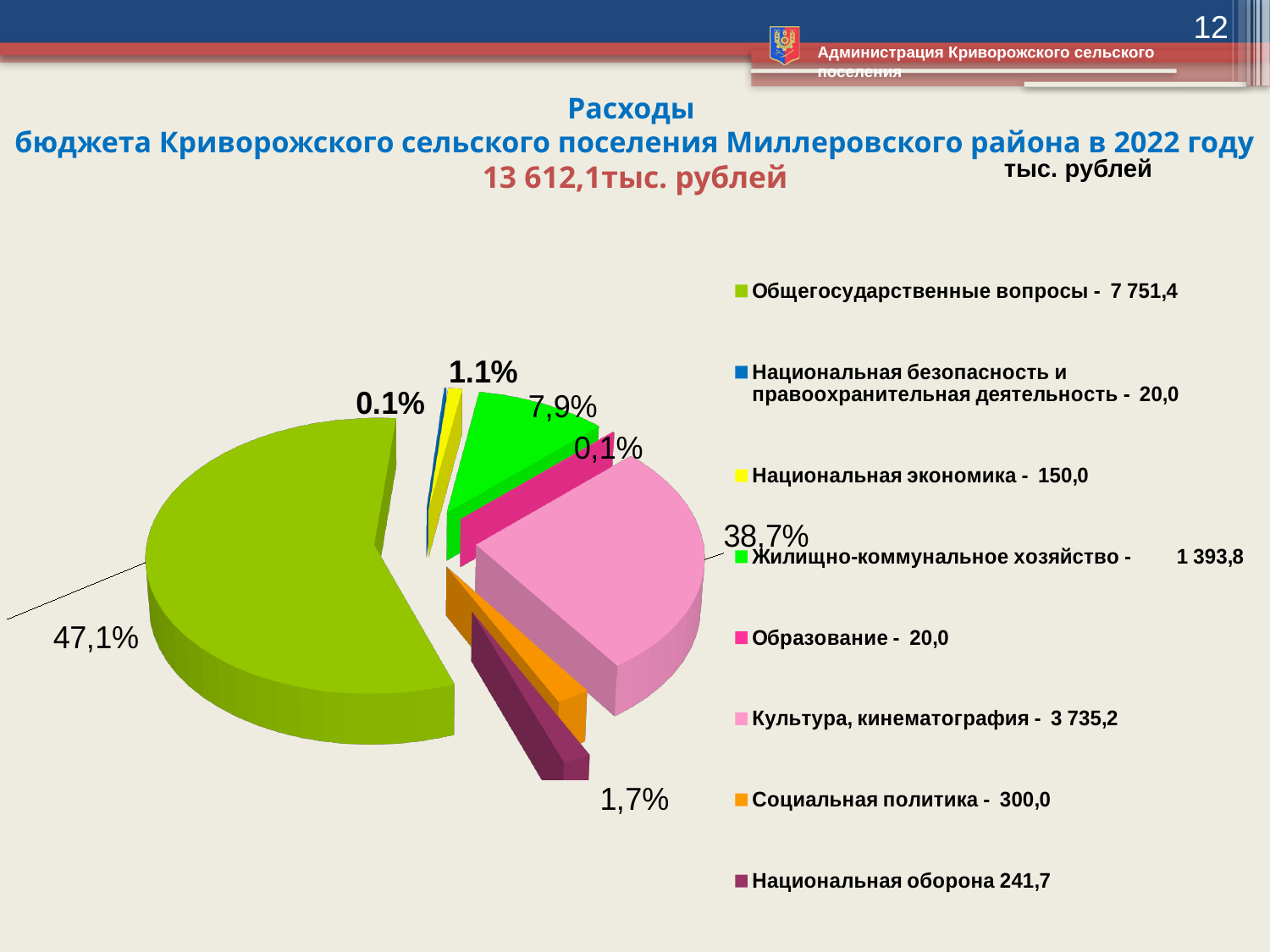
What total expenditure amount is stated in the chart title? 13 612,1 тыс. рублей What percentage share is labelled on the largest slice of the pie chart? 47,1% What value is shown for Общегосударственные вопросы? 7 751,4 What value is shown for Социальная политика? 300,0 What is the difference between the values for Общегосударственные вопросы and Культура, кинематография? 4 016,2 How many categories does the legend of the pie chart list? 8 Which is larger: Жилищно-коммунальное хозяйство or Социальная политика? Жилищно-коммунальное хозяйство Which category has the largest value in the pie chart? Общегосударственные вопросы What value is shown for Национальная оборона? 241,7 What value is shown for Культура, кинематография? 3 735,2 What value is shown for Национальная экономика? 150,0 What kind of chart is shown on the slide? pie chart